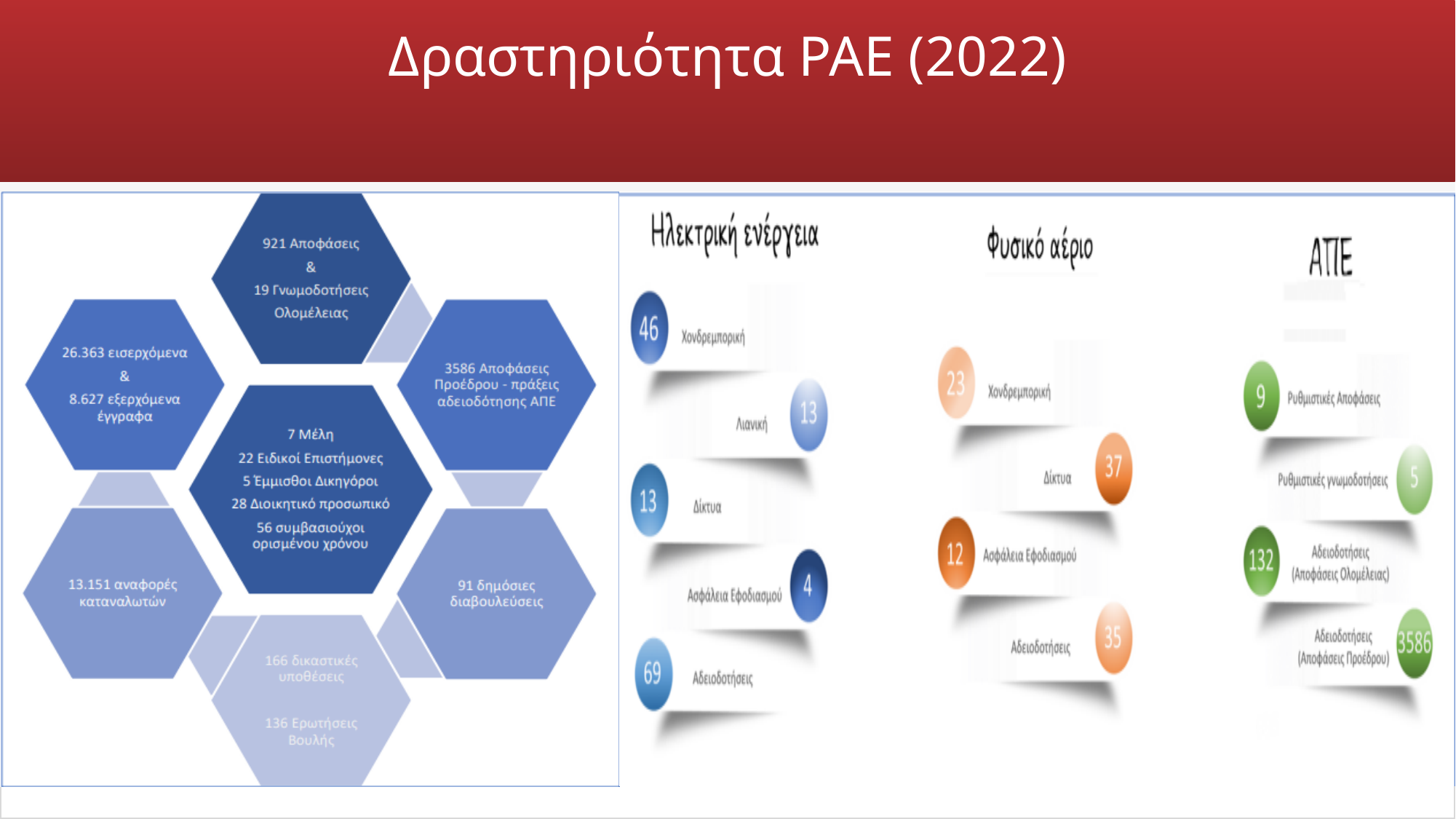
In the Ηλεκτρική ενέργεια diagram, which category has the lowest value? Ασφάλεια Εφοδιασμού In the Φυσικό αέριο diagram, what is the difference between Δίκτυα and Ασφάλεια Εφοδιασμού? 25 In the Φυσικό αέριο diagram, which category has the highest value? Δίκτυα In the hexagon diagram on the left, how many δημόσιες διαβουλεύσεις are reported? 91 In the hexagon diagram on the left, how many αναφορές καταναλωτών are reported? 13.151 In the Ηλεκτρική ενέργεια diagram, what is the value for Αδειοδοτήσεις? 69 In the ΑΠΕ diagram, what is the value for Αδειοδοτήσεις (Αποφάσεις Προέδρου)? 3586 In the ΑΠΕ diagram, what is the value for Αδειοδοτήσεις (Αποφάσεις Ολομέλειας)? 132 In the ΑΠΕ diagram, which is larger: Ρυθμιστικές Αποφάσεις or Ρυθμιστικές γνωμοδοτήσεις? Ρυθμιστικές Αποφάσεις In the Ηλεκτρική ενέργεια diagram, what is the value for Χονδρεμπορική? 46 In the Ηλεκτρική ενέργεια diagram, how many categories are shown? 5 In the Φυσικό αέριο diagram, what is the value for Δίκτυα? 37